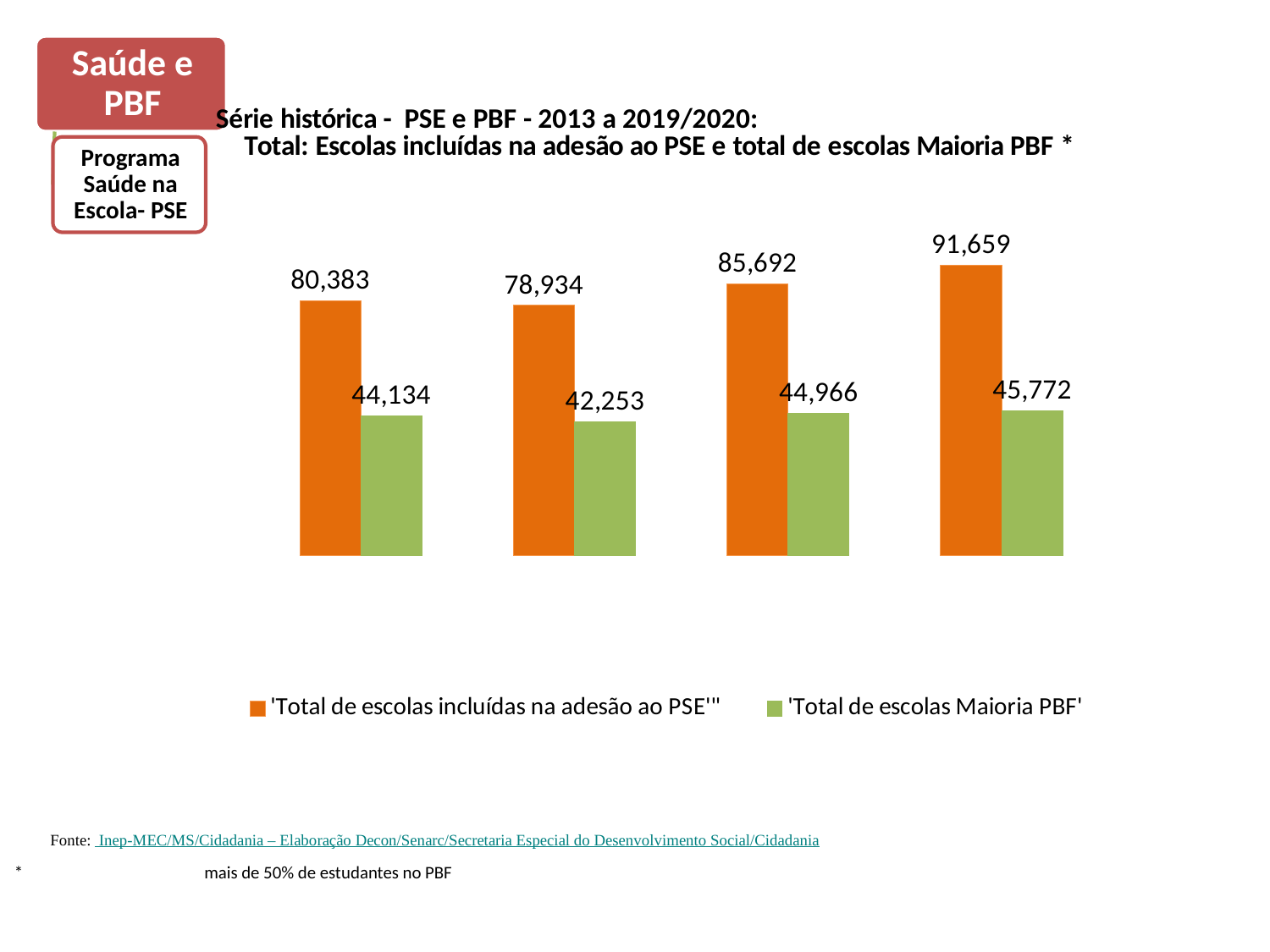
Which group of bars has the lowest value for 'Total de escolas Maioria PBF'? the second group from the left Does the value of 'Total de escolas incluídas na adesão ao PSE' rise or fall from the second group to the fourth group? rise How much higher is 'Total de escolas incluídas na adesão ao PSE' in the third group than in the first group? 5,309 What is the value of 'Total de escolas Maioria PBF' in the second group of bars from the left? 42,253 Which group of bars has the highest value for 'Total de escolas incluídas na adesão ao PSE'? the fourth (rightmost) group In the fourth (rightmost) group, what is the difference between 'Total de escolas incluídas na adesão ao PSE' and 'Total de escolas Maioria PBF'? 45,887 What is the value of 'Total de escolas incluídas na adesão ao PSE' in the fourth (rightmost) group of bars? 91,659 What colour are the bars for 'Total de escolas incluídas na adesão ao PSE'? orange Which is larger: 'Total de escolas Maioria PBF' in the first group or in the third group? the third group How many groups of bars are plotted in the chart? 4 What kind of chart is shown on the slide? bar chart How many series does the legend list? 2